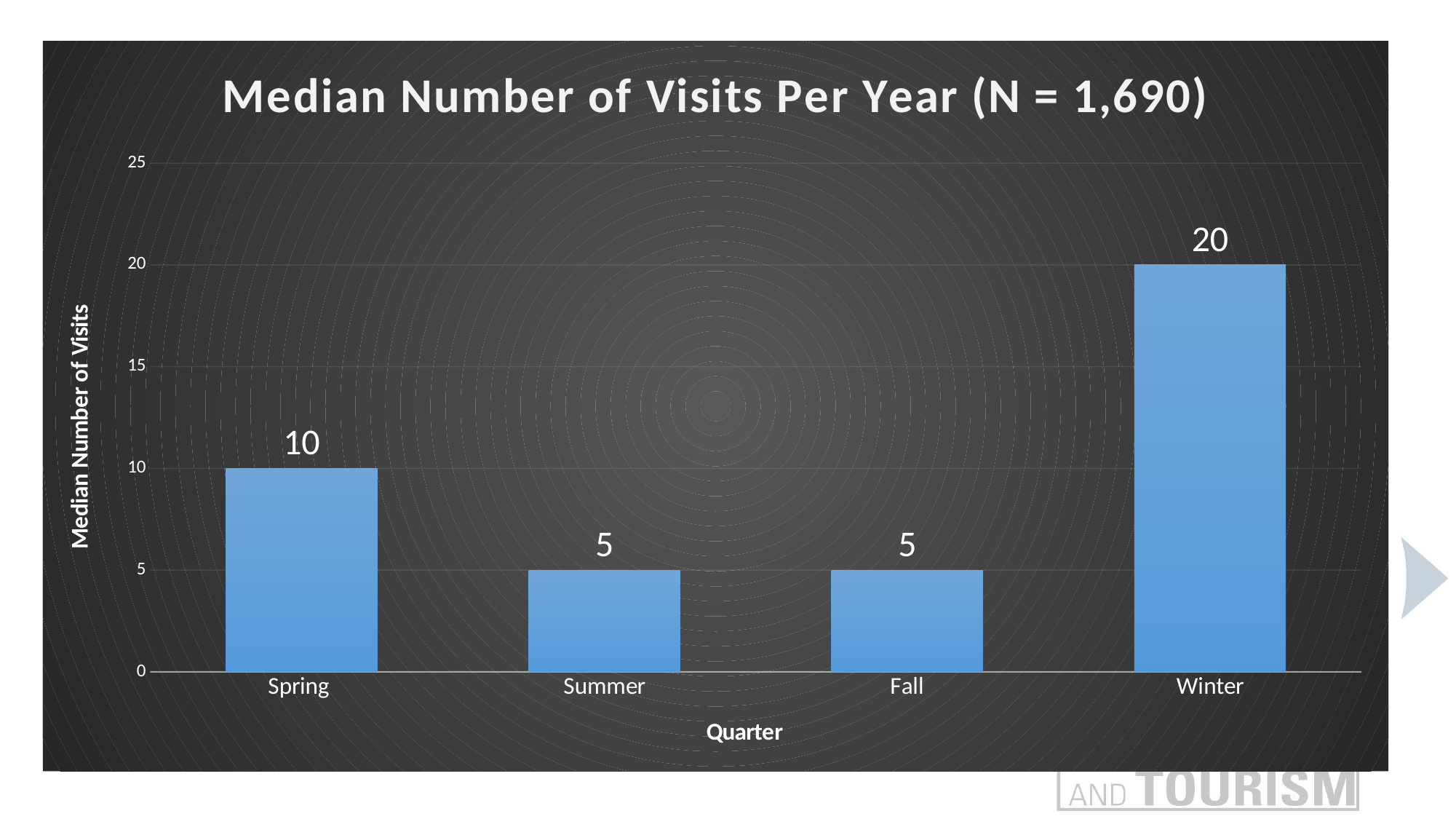
What is the median number of visits for Spring? 10 How many quarters are shown on the x axis? 4 What is the difference between the median number of visits for Winter and Spring? 10 What is the median number of visits for Winter? 20 What is the median number of visits for Summer? 5 Which quarter has the highest median number of visits? Winter What is the title of the chart? Median Number of Visits Per Year (N = 1,690) What is the difference between the median number of visits for Spring and Fall? 5 What kind of chart is shown on the slide? bar chart Is the value for Winter greater or less than 15? greater What is the label of the x axis? Quarter Which has a larger median number of visits, Spring or Summer? Spring